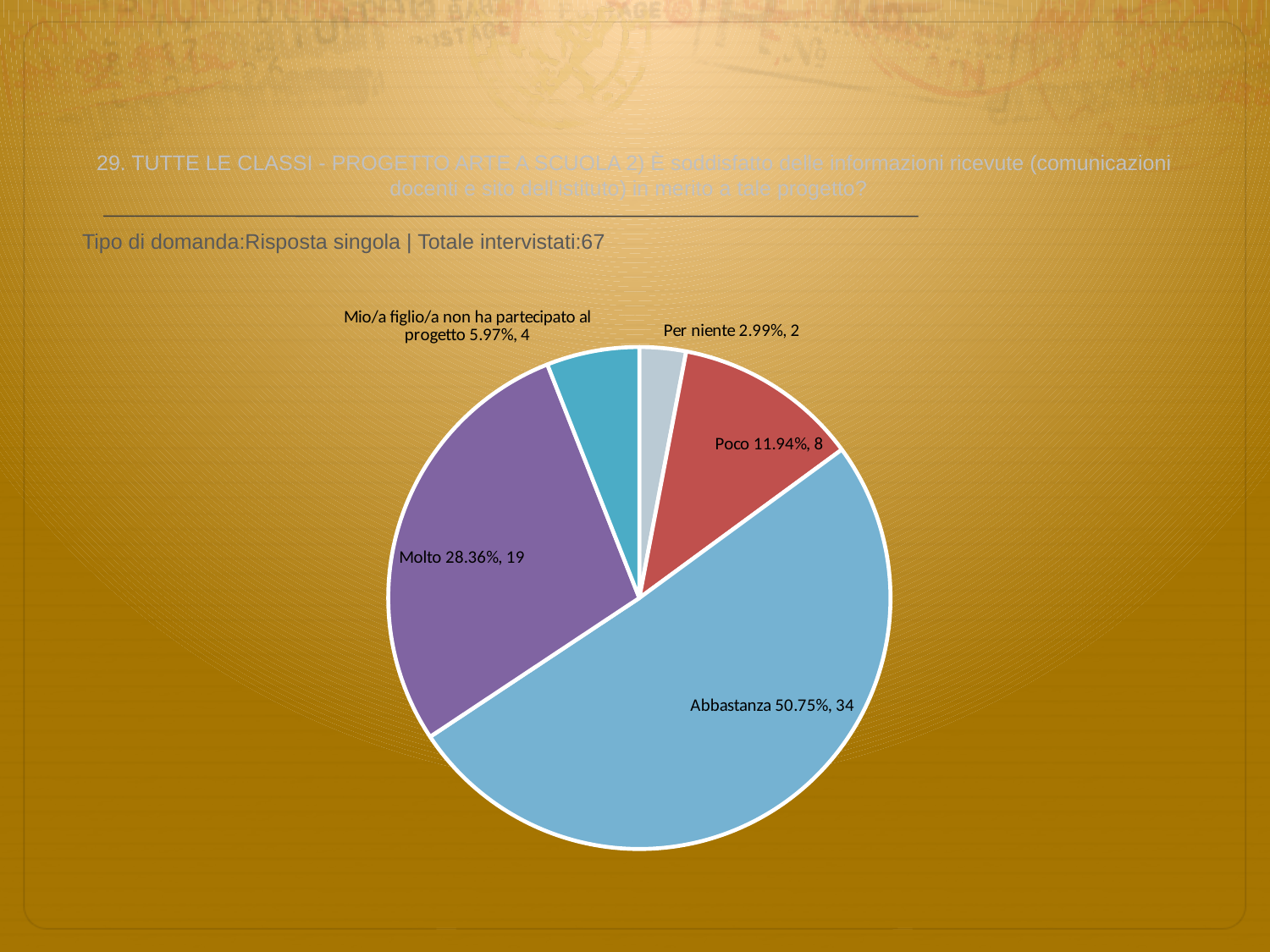
What kind of chart is shown on the slide? pie chart How many respondents answered 'Poco'? 8 What percentage share does the 'Per niente' slice have? 2.99% What percentage share does the 'Mio/a figlio/a non ha partecipato al progetto' slice have? 5.97% What percentage share does the 'Abbastanza' slice have? 50.75% How many slices does the pie chart have? 5 How many respondents answered 'Molto'? 19 What is the total number of respondents (Totale intervistati) stated on the slide? 67 Which has more respondents, 'Poco' or 'Mio/a figlio/a non ha partecipato al progetto'? Poco Which category has the smallest slice? Per niente What is the difference in respondent count between 'Abbastanza' and 'Molto'? 15 Which category has the largest slice? Abbastanza